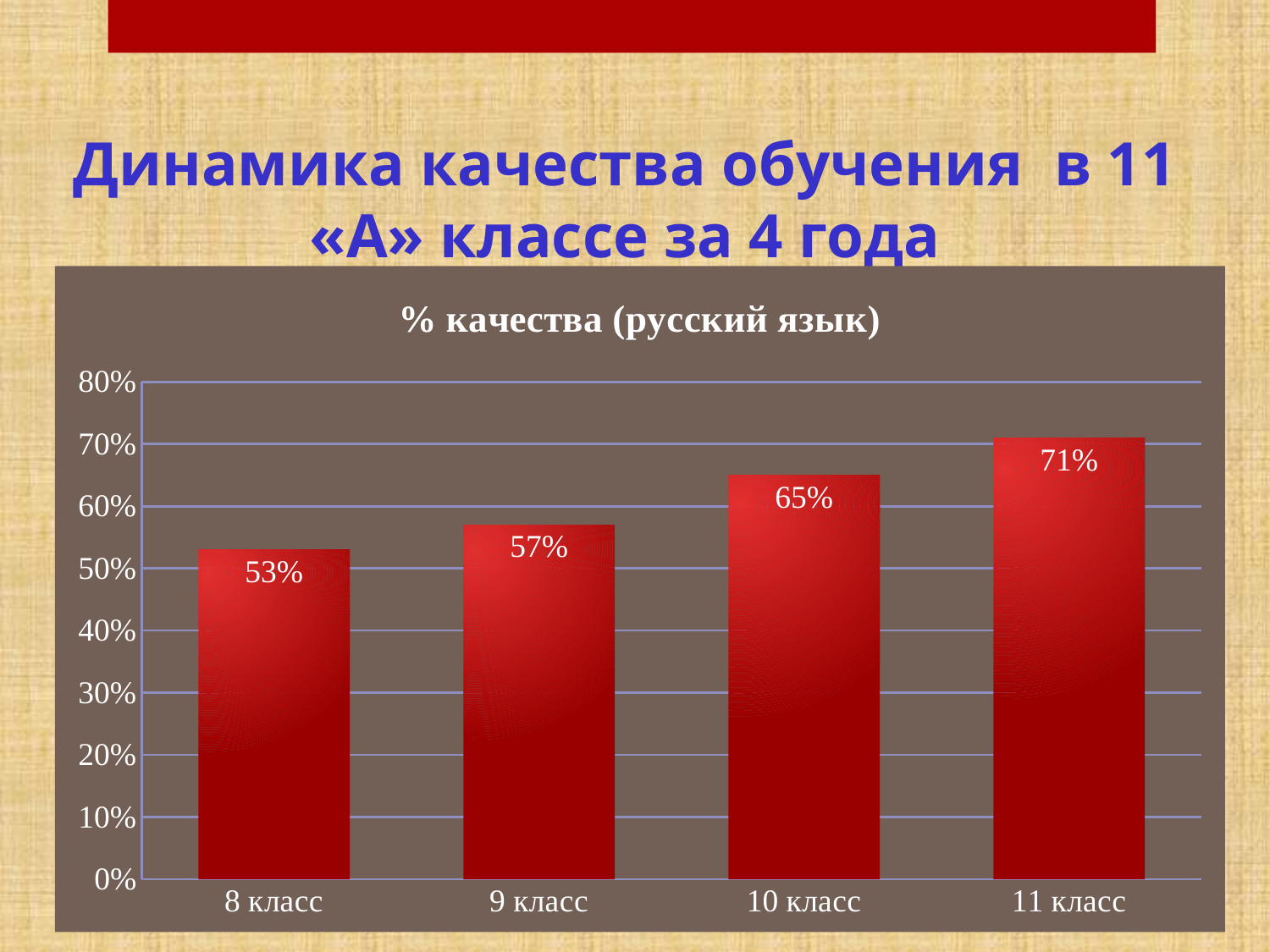
What is the value for 11 класс? 71% How many categories are shown on the x axis? 4 What is the value for 8 класс? 53% Which category has the lowest value? 8 класс Do the values rise or fall from 8 класс to 11 класс? rise Which is larger, the value for 9 класс or the value for 10 класс? 10 класс What is the value for 10 класс? 65% What is the difference between the values for 11 класс and 8 класс? 18% Which category has the highest value? 11 класс What is the value for 9 класс? 57% Is the value for 10 класс greater or less than 60%? greater What kind of chart is this? bar chart